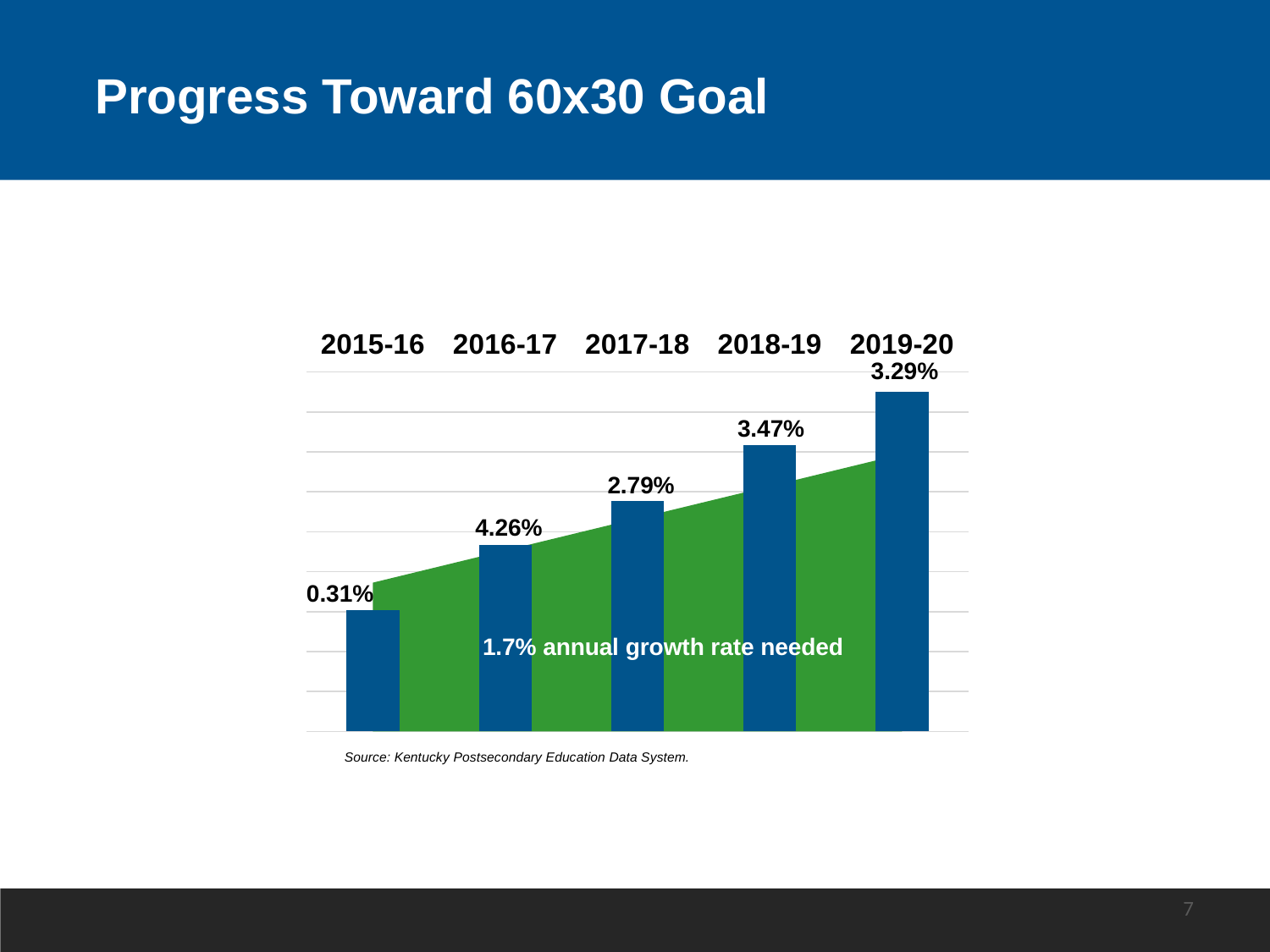
What is the value shown for 2019-20? 3.29% What is the value shown for 2015-16? 0.31% What is the title of the slide? Progress Toward 60x30 Goal What annual growth rate does the green area on the chart say is needed? 1.7% What is the difference between the labeled values for 2018-19 and 2019-20? 0.18% What is the value shown for 2018-19? 3.47% What is the value shown for 2016-17? 4.26% What kind of chart is shown on the slide? Combination bar and area chart How many academic years are shown on the chart? 5 What is the difference between the labeled values for 2016-17 and 2015-16? 3.95% What is the value shown for 2017-18? 2.79%